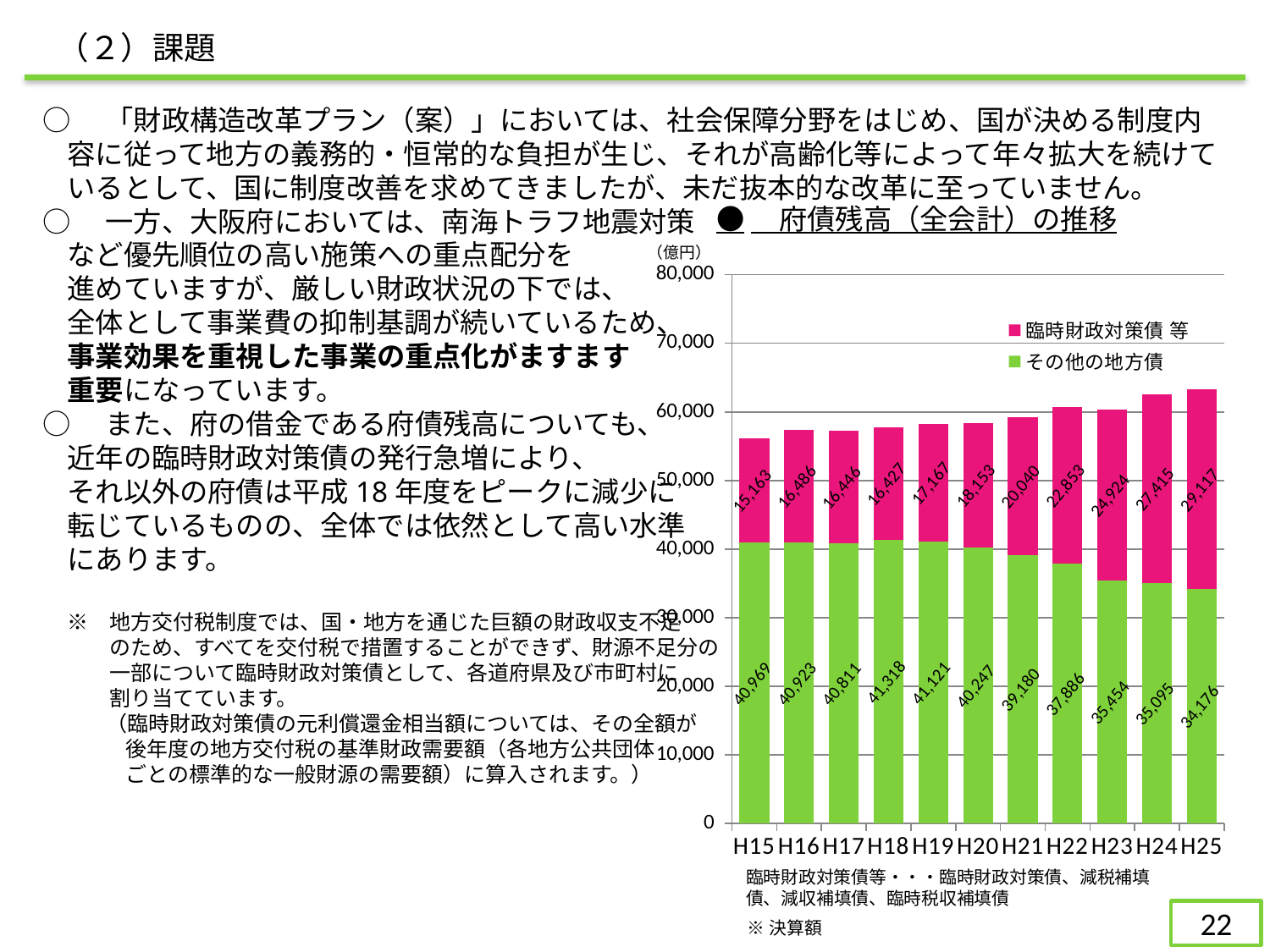
Which colour represents その他の地方債 in the chart? Green What is the total stacked value for H25? 63,293 In which year is 臨時財政対策債 等 highest? H25 What is the difference between the 臨時財政対策債 等 values for H25 and H15? 13,954 Does 臨時財政対策債 等 rise or fall from H19 to H25? Rise How many series does the chart legend list? 2 How many fiscal years (categories) are shown on the x axis of the chart? 11 What kind of chart is shown on the slide? Stacked bar chart What is the value of 臨時財政対策債 等 for H25? 29,117 What is the value of その他の地方債 for H18? 41,318 What is the value of 臨時財政対策債 等 for H15? 15,163 In which year is その他の地方債 lowest? H25